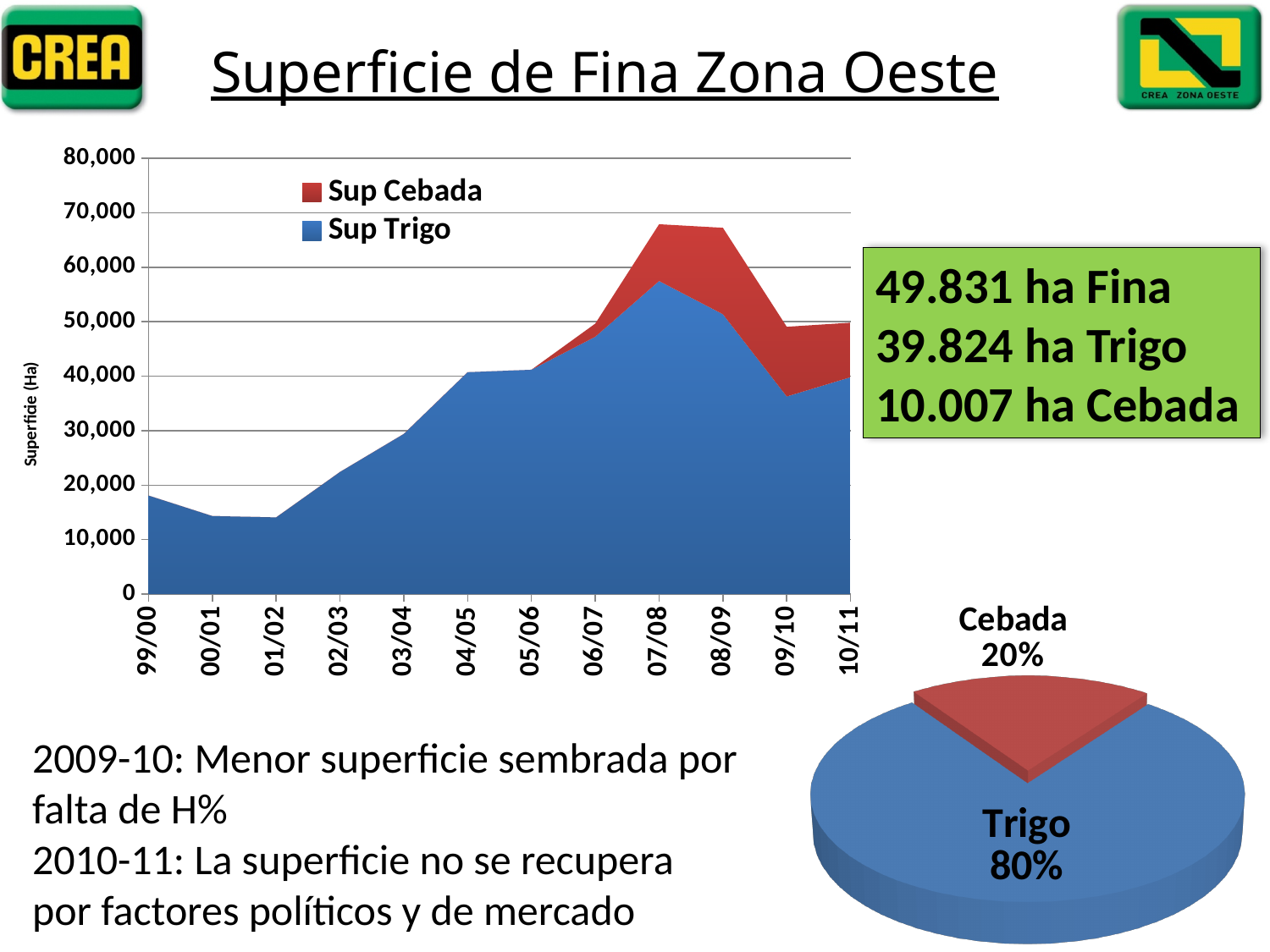
In the area chart, which series is shown in red? Sup Cebada In the area chart, is the Sup Trigo value for 09/10 greater or less than 40,000? less In the area chart, which season has the highest total surface (Trigo plus Cebada)? 07/08 In the pie chart at the bottom right, what share does Cebada have? 20% In the area chart, how many series does the legend list? 2 In the area chart, is the Sup Trigo value for 99/00 greater or less than 20,000? less In the area chart, is the total surface for 07/08 greater or less than 60,000? greater What kind of chart is the top-left chart titled with the y-axis 'Superficie (Ha)'? area chart In the pie chart at the bottom right, what share does Trigo have? 80% In the area chart, how many seasons are shown on the x axis? 12 In the pie chart at the bottom right, which slice is the largest? Trigo In the area chart, does the Sup Trigo surface rise or fall from 01/02 to 07/08? rise